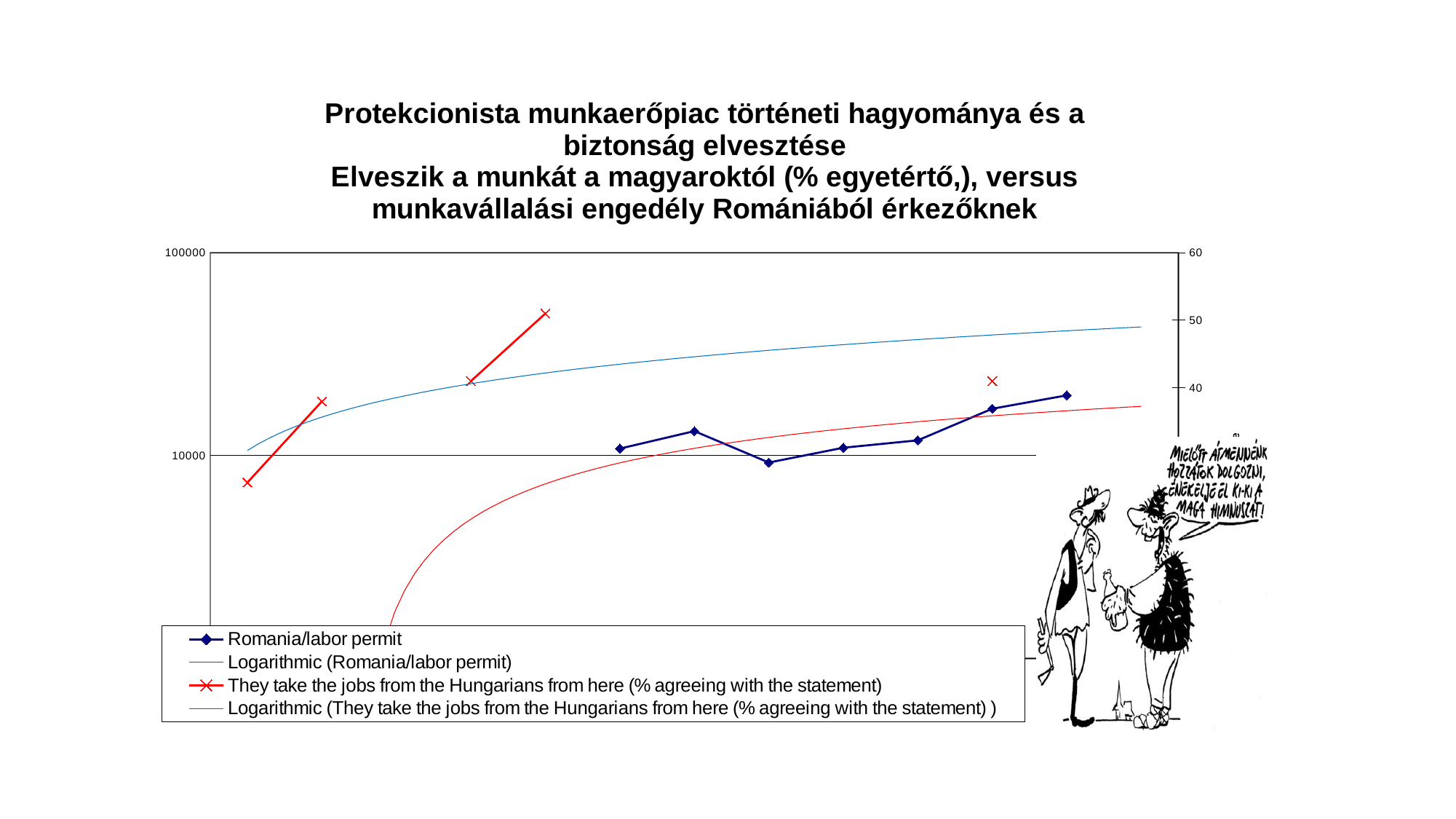
Which series is drawn with red x markers? They take the jobs from the Hungarians from here (% agreeing with the statement) What kind of chart is shown on the slide? line chart Overall, does the Romania/labor permit series rise or fall from left to right? rise Is the last (rightmost) value of the Romania/labor permit series greater or less than 100000? less Is the last (rightmost) value of the Romania/labor permit series greater or less than 10000? greater Which point of the 'They take the jobs from the Hungarians from here' series is the highest? the fourth point How many series does the legend list? 4 Is the first (leftmost) value of the 'They take the jobs from the Hungarians from here' series greater or less than 40 on the right axis? less Which series is drawn with diamond markers? Romania/labor permit How many data points are plotted for the Romania/labor permit series? 7 Which point of the Romania/labor permit series is the highest? the last (rightmost) point How many data points are plotted for the series 'They take the jobs from the Hungarians from here (% agreeing with the statement)'? 5